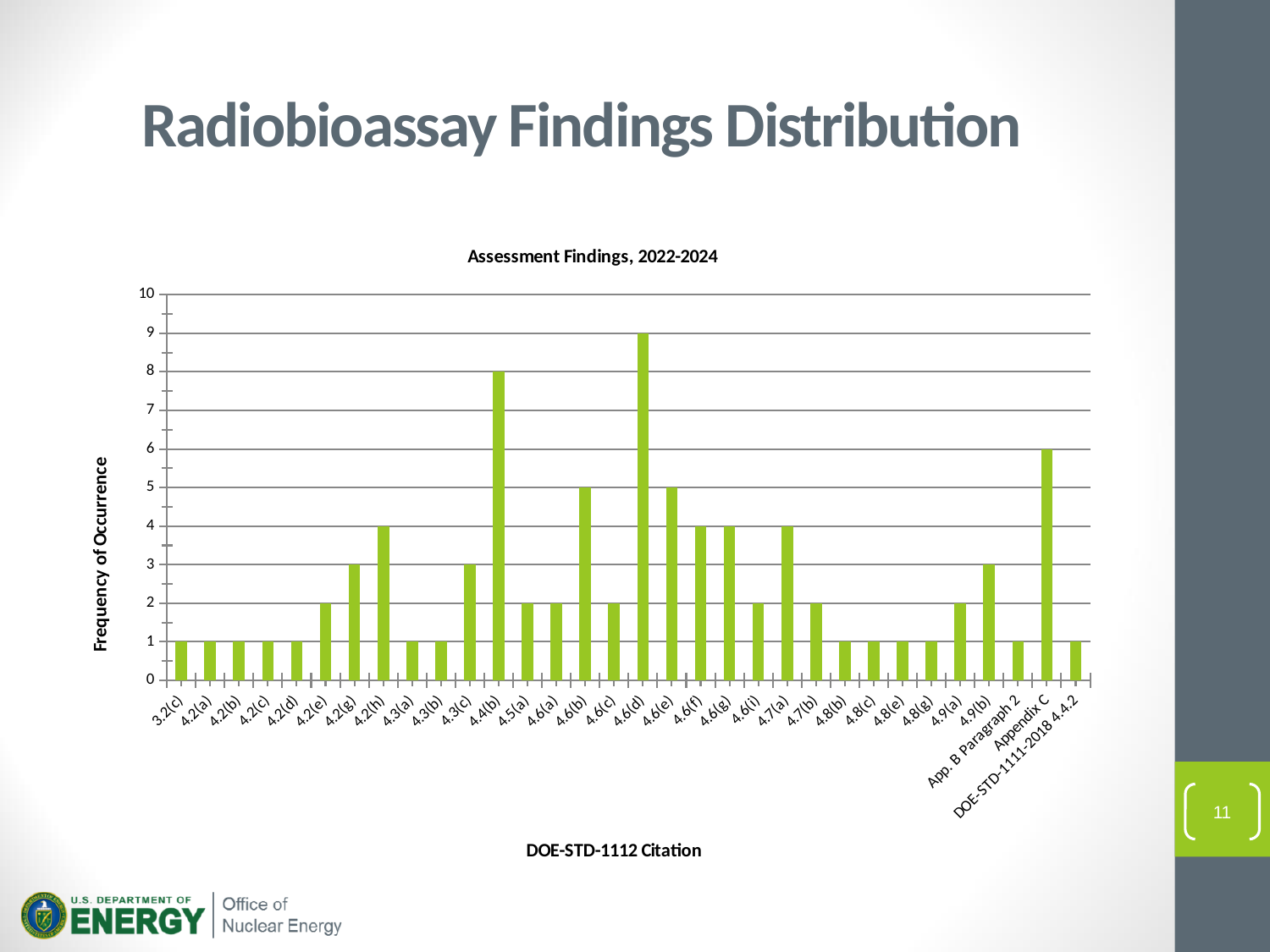
What is the label of the y axis? Frequency of Occurrence Which has a higher frequency of occurrence, Appendix C or citation 4.6(b)? Appendix C Which citation has the highest frequency of occurrence? 4.6(d) What is the frequency of occurrence for citation 4.4(b)? 8 What type of chart is shown on the slide? Bar chart What is the frequency of occurrence for citation 4.6(d)? 9 What is the title of the chart? Assessment Findings, 2022-2024 Is the frequency of occurrence for citation 4.6(d) greater or less than 8? greater How many citation categories are shown on the x axis? 32 What is the frequency of occurrence for Appendix C? 6 What is the difference in frequency between citation 4.6(d) and citation 4.4(b)? 1 What is the frequency of occurrence for citation 4.2(h)? 4